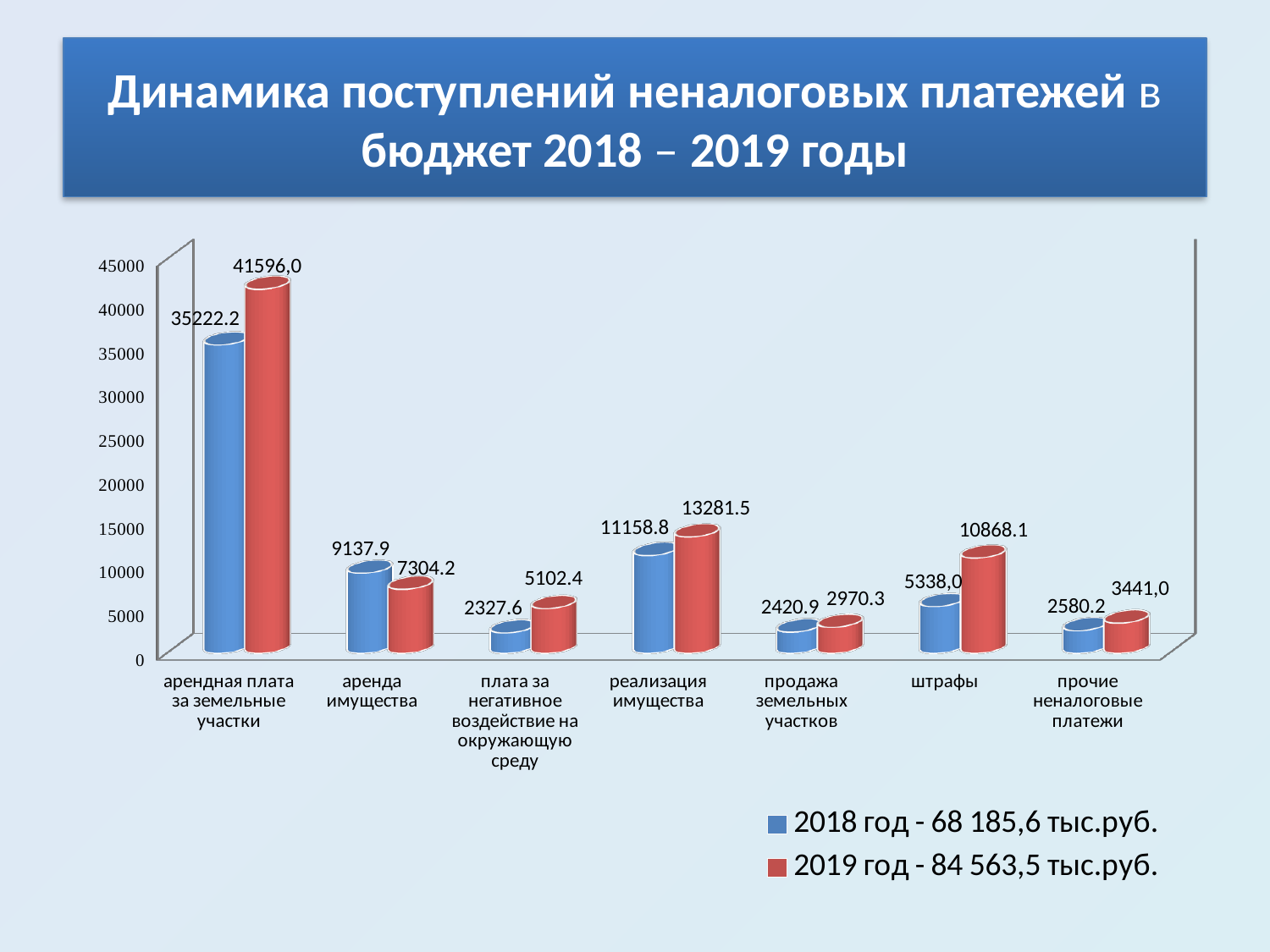
For аренда имущества, which year has the larger value, 2018 or 2019? 2018 What is the 2018 value for реализация имущества? 11158.8 What kind of chart is shown on the slide? bar chart What is the difference between the 2019 and 2018 values for штрафы? 5530.1 What total for 2019 is given in the legend? 84 563,5 тыс.руб. Which category has the lowest 2018 value? плата за негативное воздействие на окружающую среду How many categories are shown on the x axis? 7 What is the 2019 value for плата за негативное воздействие на окружающую среду? 5102.4 Which category has the highest 2019 value? арендная плата за земельные участки What is the 2019 value for арендная плата за земельные участки? 41596,0 What is the 2018 value for штрафы? 5338,0 How many series does the legend list? 2